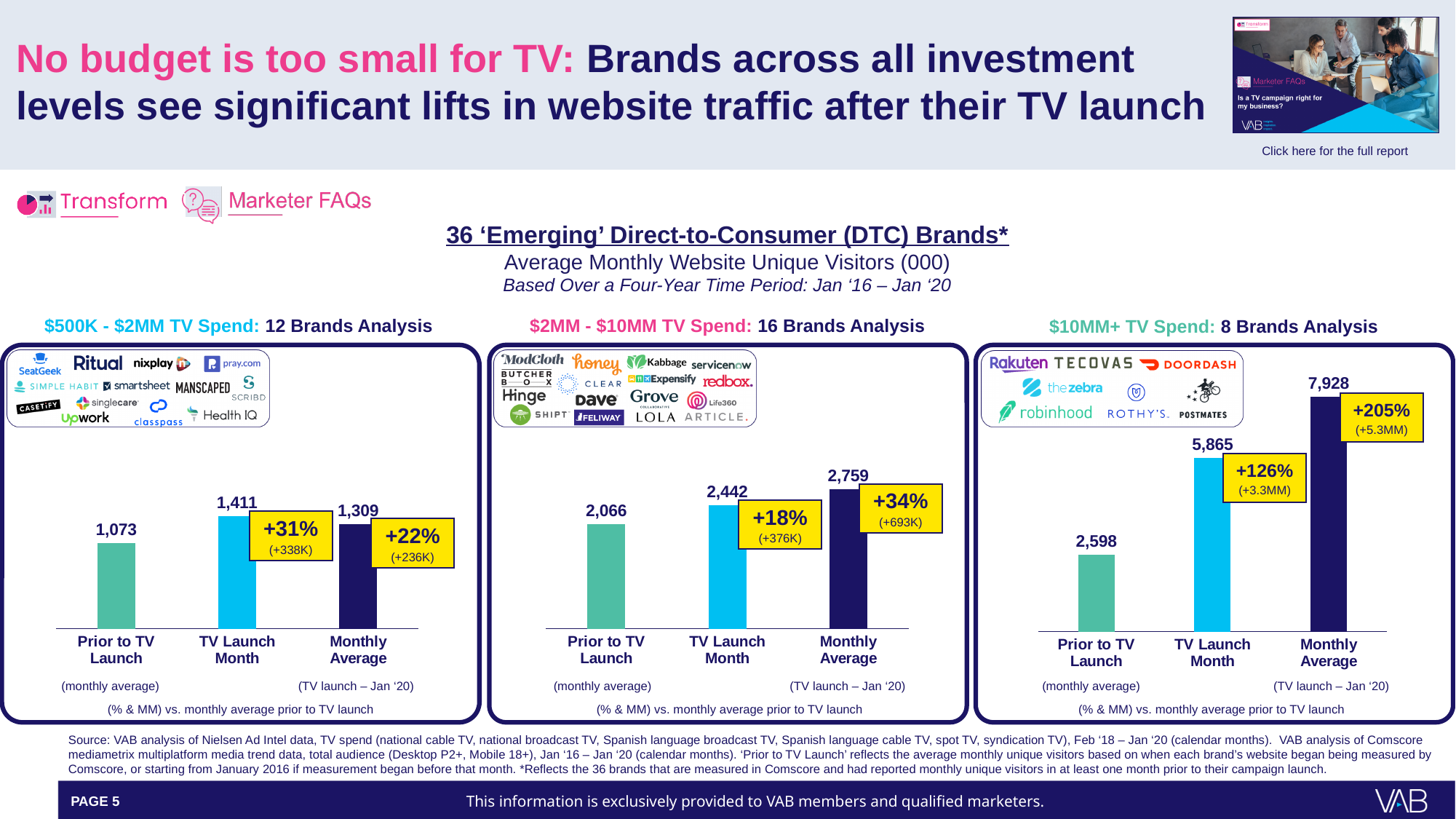
How many categories are plotted in the $10MM+ TV Spend chart? 3 In the $2MM - $10MM TV Spend chart, which category has the lowest value? Prior to TV Launch In the $2MM - $10MM TV Spend chart, do the values rise or fall from left to right? rise In the $500K - $2MM TV Spend chart, which category has the highest value? TV Launch Month In the $10MM+ TV Spend chart, what is the value for Monthly Average? 7,928 In the $500K - $2MM TV Spend chart, what is the difference between TV Launch Month and Prior to TV Launch? 338 In the $500K - $2MM TV Spend chart, what is the value for Prior to TV Launch? 1,073 In the $10MM+ TV Spend chart, which is larger: TV Launch Month or Prior to TV Launch? TV Launch Month In the $2MM - $10MM TV Spend chart, what is the value for TV Launch Month? 2,442 In the $10MM+ TV Spend chart, what percentage lift is shown for the TV Launch Month bar? +126% In the $2MM - $10MM TV Spend chart, what is the difference between Monthly Average and Prior to TV Launch? 693 In the $500K - $2MM TV Spend chart, what percentage lift is shown for the Monthly Average bar? +22%